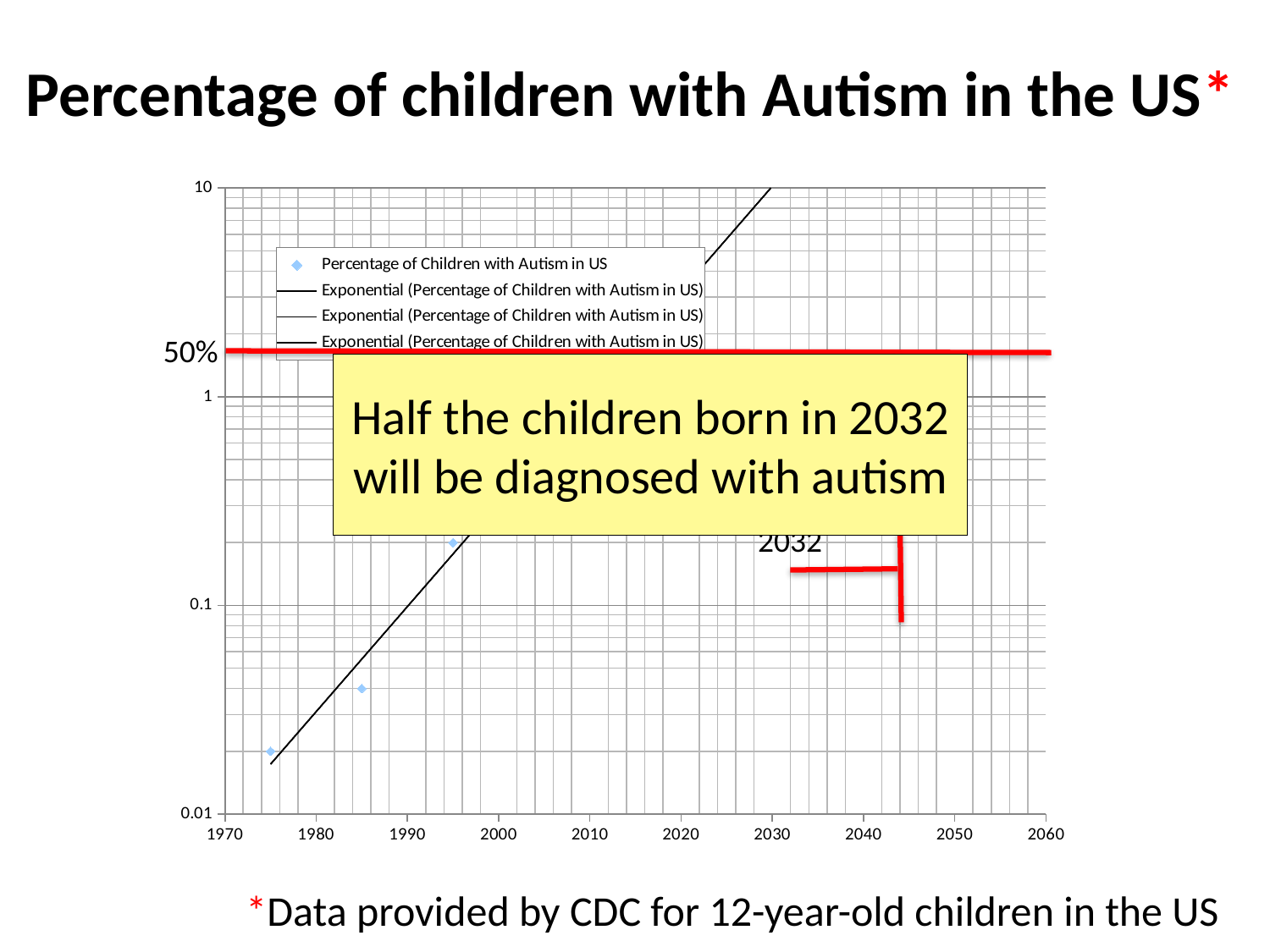
What is the title of the slide's chart? Percentage of children with Autism in the US According to the annotation on the chart, in which year will half the children born be diagnosed with autism? 2032 Is the plotted value for 1995 greater or less than 0.1? greater Which plotted data point is higher, the one for 1975 or the one for 1995? 1995 How many entries does the chart legend list? 4 Do the plotted data points rise or fall as the year increases along the x axis? Rise What kind of chart is shown on the slide? Scatter chart with exponential trendlines Is the plotted value for 1975 greater or less than 0.1? less Is the plotted value for 1985 greater or less than 0.1? less